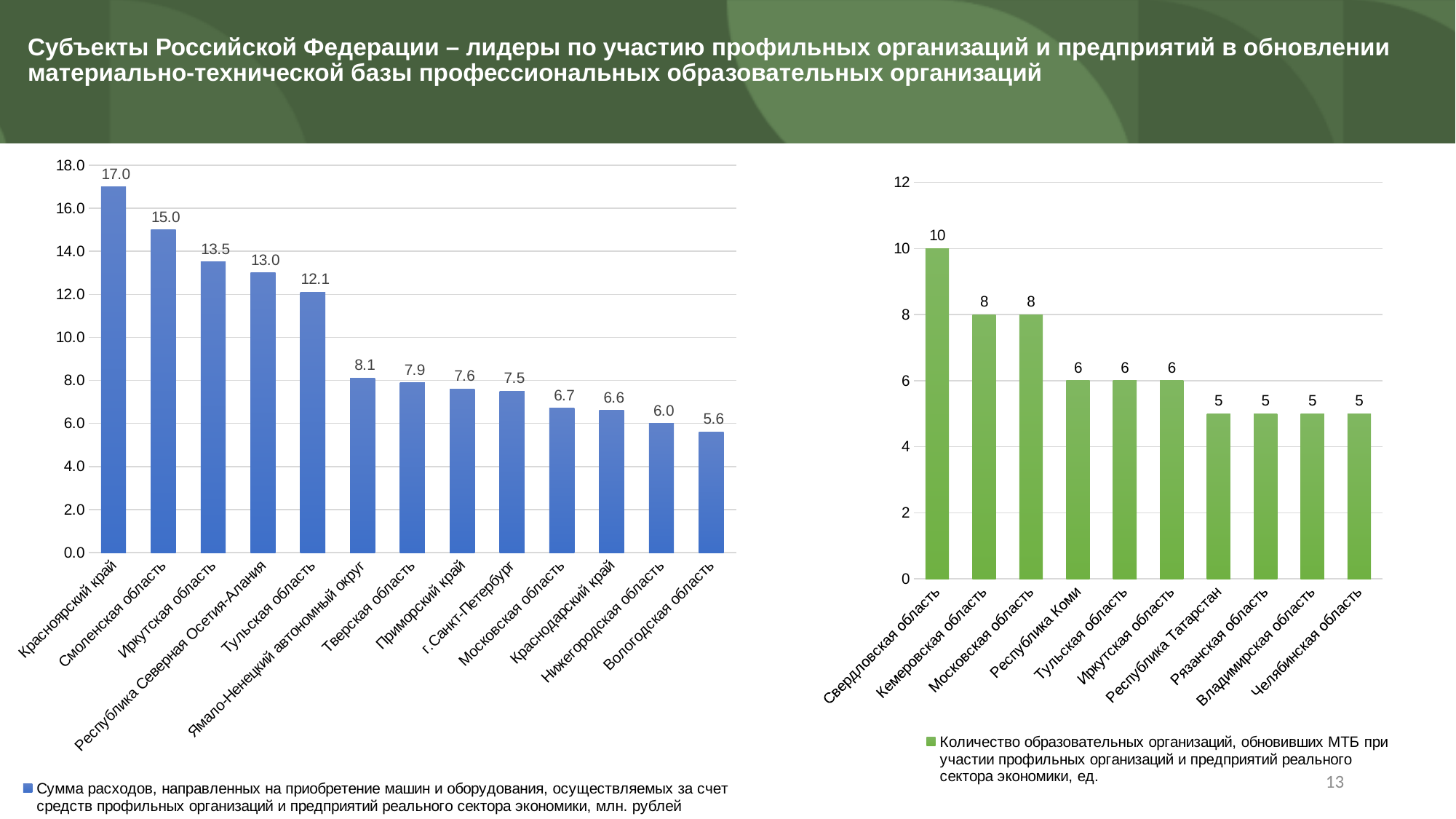
How many regions are shown in the right chart? 10 In the left chart, what is the value for Красноярский край? 17.0 In the right chart, what is the value for Свердловская область? 10 In the left chart, which is larger: the value for Приморский край or the value for г.Санкт-Петербург? Приморский край In the left chart, which region has the lowest value? Вологодская область What type of chart is the right chart? bar chart How many regions are shown in the left chart? 13 In the left chart, what is the difference between the values for Смоленская область and Иркутская область? 1.5 In the left chart, what is the value for Тульская область? 12.1 In the right chart, which region has the highest value? Свердловская область In the left chart, do the values rise or fall from left to right along the x axis? fall In the right chart, what is the difference between the values for Кемеровская область and Республика Коми? 2